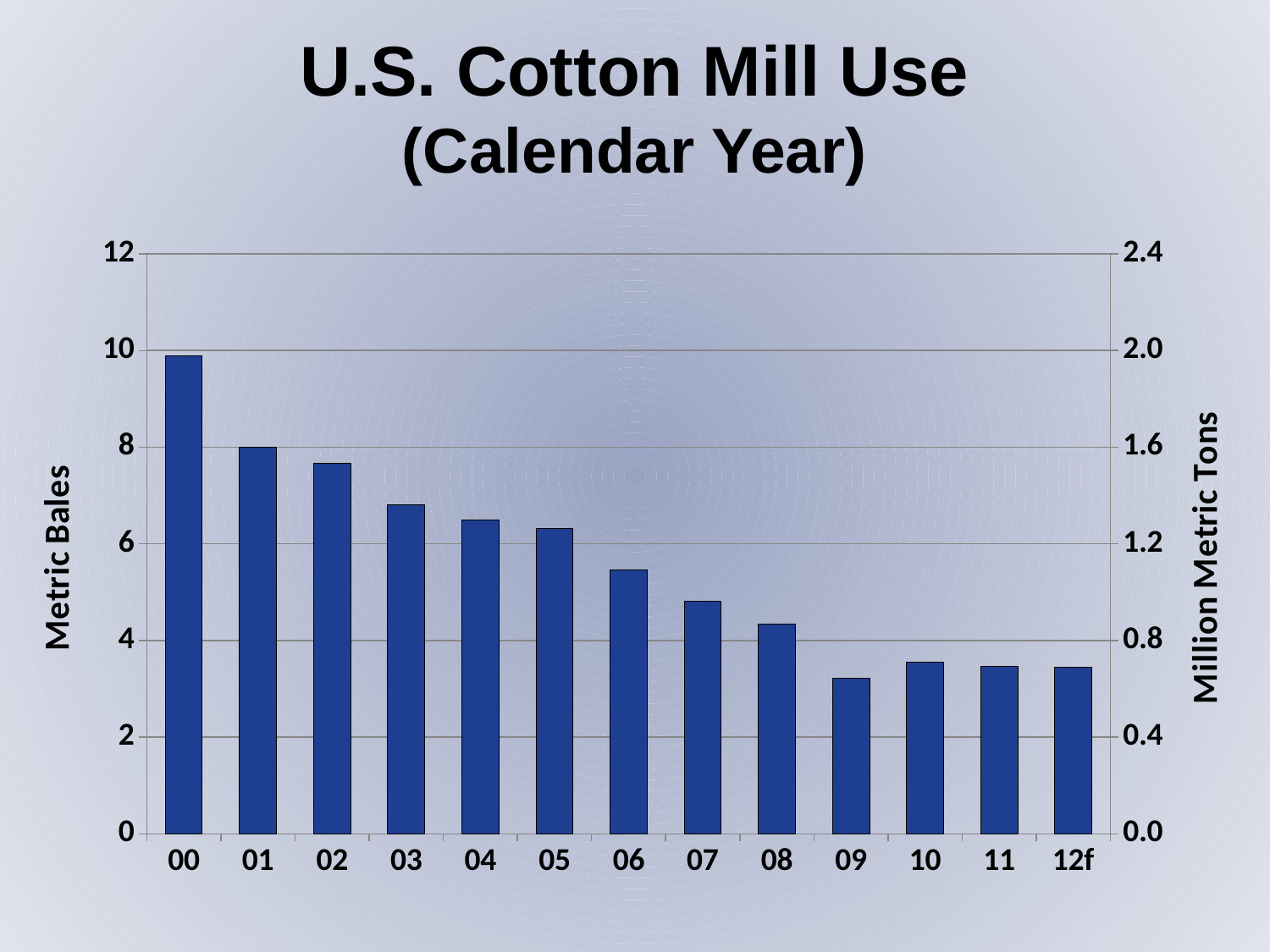
Is the value for 06 greater or less than 6 million bales? less How many years (bars) are plotted on the chart? 13 What is the title of the chart? U.S. Cotton Mill Use (Calendar Year) Is the value for 00 greater or less than 8 million bales? greater Which year has the highest cotton mill use? 00 Which year has the larger value, 07 or 10? 07 What is the label on the right-hand vertical axis? Million Metric Tons Is the value for 09 greater or less than 4 million bales? less Which year has the larger value, 02 or 05? 02 What kind of chart is shown on the slide? bar chart Do the values generally rise or fall from 00 to 12f? fall